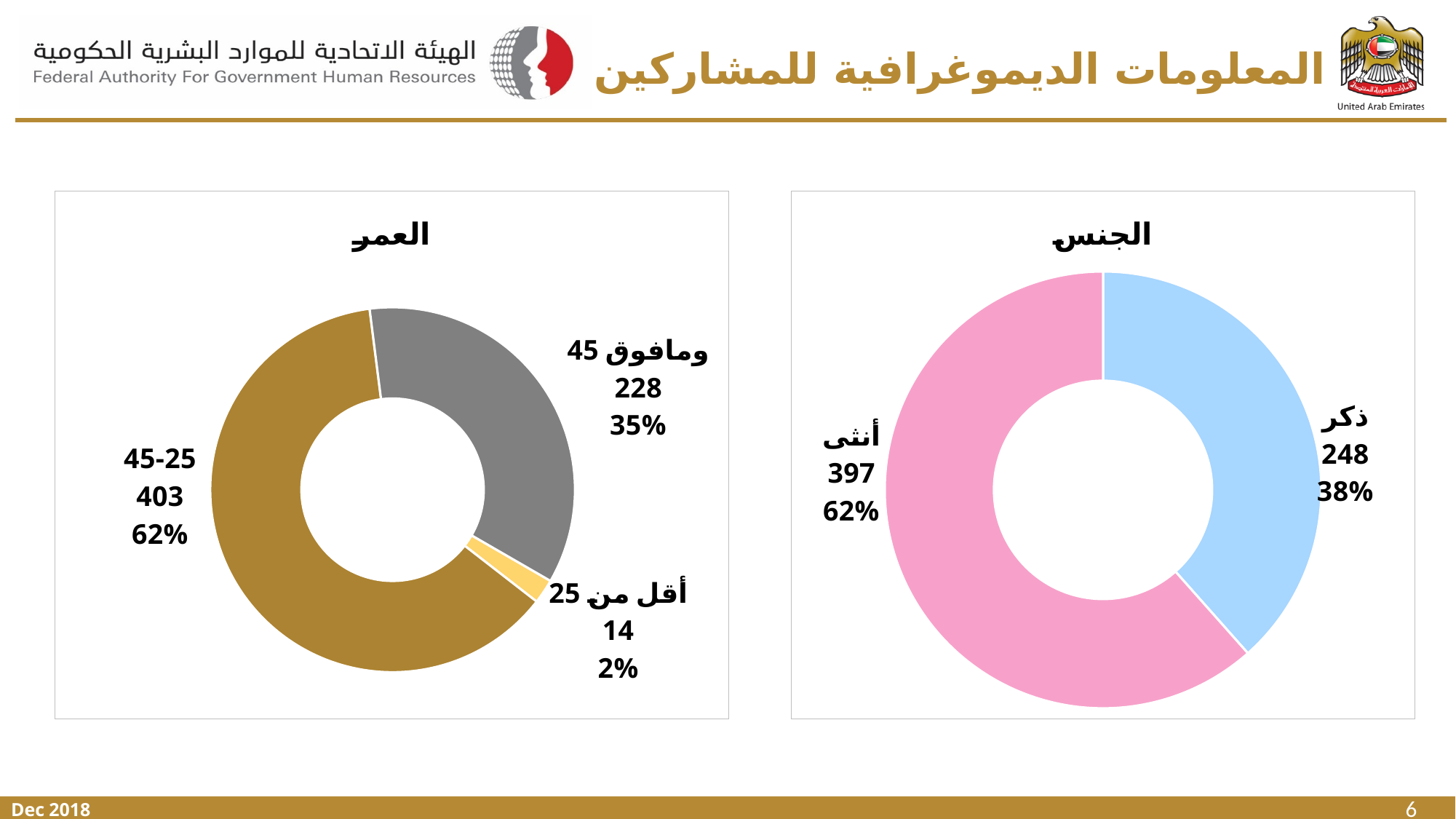
In the "العمر" (Age) chart, how many participants are in the "أقل من 25" (under 25) category? 14 In the "العمر" (Age) chart, how many participants are in the "45-25" category? 403 In the "الجنس" (Gender) chart, which category is larger, "ذكر" or "أنثى"? أنثى In the "الجنس" (Gender) chart, what is the difference between the number of "أنثى" and "ذكر" participants? 149 In the "العمر" (Age) chart, what percentage share is shown for "45 ومافوق" (45 and above)? 35% In the "الجنس" (Gender) chart, how many participants are "أنثى" (female)? 397 What type of chart is the "الجنس" (Gender) chart? Donut (pie) chart How many categories are shown in the "العمر" (Age) chart? 3 In the "العمر" (Age) chart, which age category has the smallest share? أقل من 25 In the "العمر" (Age) chart, which age category has the largest share? 45-25 In the "العمر" (Age) chart, what is the difference in participant count between "45-25" and "45 ومافوق"? 175 In the "الجنس" (Gender) chart, what percentage share is shown for "ذكر" (male)? 38%